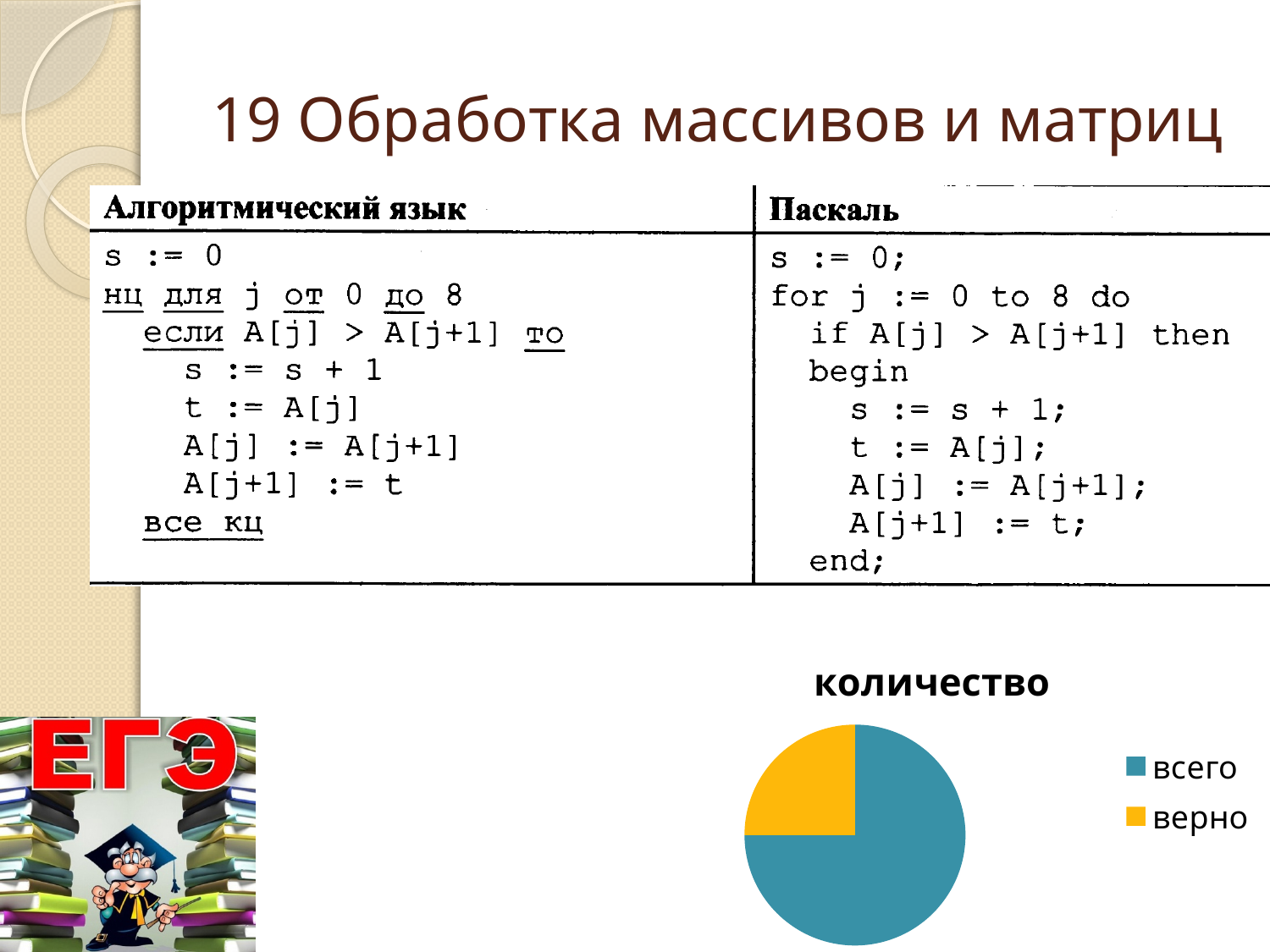
Which slice of the pie chart is the largest? всего What is the title of the pie chart? количество Which legend entry is shown in yellow in the pie chart? верно Which is larger in the pie chart, всего or верно? всего What kind of chart is shown on the slide? pie chart Which slice of the pie chart is the smallest? верно How many entries does the legend of the pie chart list? 2 How many slices does the pie chart have? 2 What colour is the всего slice in the pie chart? blue